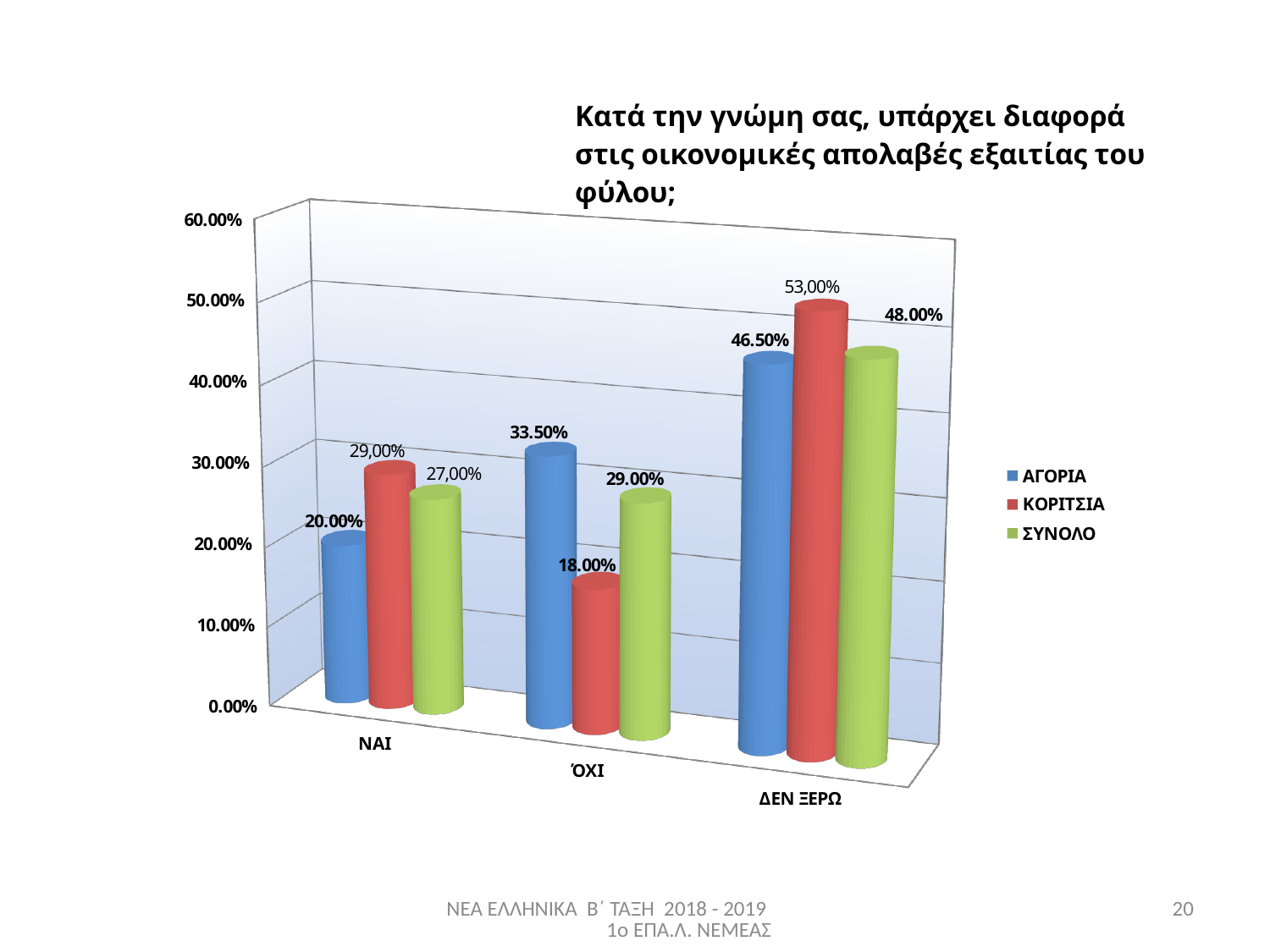
What kind of chart is shown on the slide? bar chart What is the value for ΚΟΡΙΤΣΙΑ in the ΔΕΝ ΞΕΡΩ category? 53,00% What is the value for ΣΥΝΟΛΟ in the ΌΧΙ category? 29.00% Which is larger in the ΌΧΙ category: the ΑΓΟΡΙΑ value or the ΚΟΡΙΤΣΙΑ value? ΑΓΟΡΙΑ What is the difference between the ΑΓΟΡΙΑ values for ΔΕΝ ΞΕΡΩ and ΝΑΙ? 26.50% How many series does the legend list? 3 Which category has the lowest value for the ΚΟΡΙΤΣΙΑ series? ΌΧΙ Is the value for ΚΟΡΙΤΣΙΑ in the ΔΕΝ ΞΕΡΩ category greater or less than 50.00%? greater What is the value for ΚΟΡΙΤΣΙΑ in the ΌΧΙ category? 18.00% How many categories are shown on the x axis? 3 What is the value for ΑΓΟΡΙΑ in the ΝΑΙ category? 20.00% Which category has the highest value for the ΣΥΝΟΛΟ series? ΔΕΝ ΞΕΡΩ